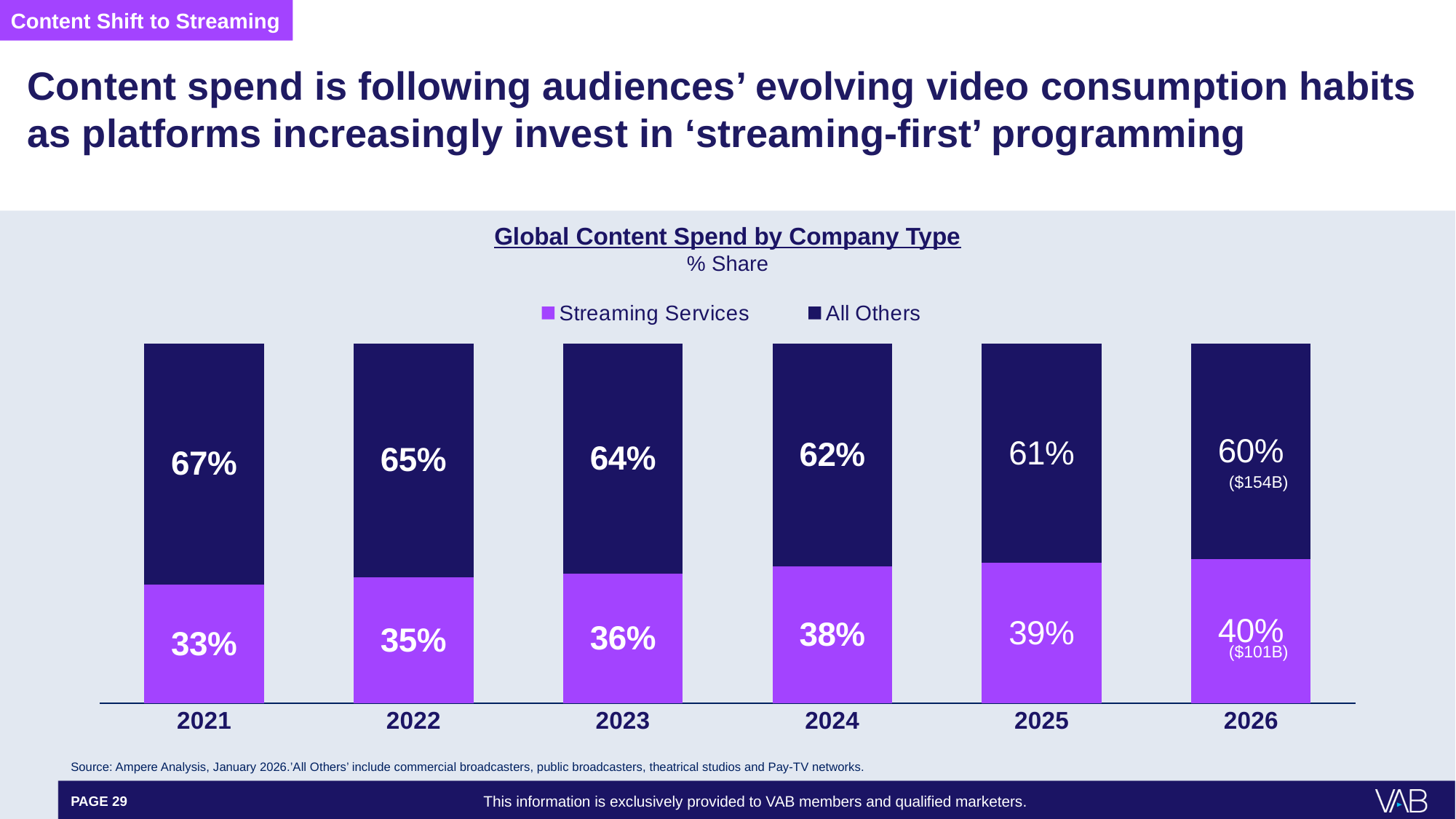
What kind of chart is shown? Stacked bar chart What is the Streaming Services share in 2026? 40% What is the Streaming Services share in 2021? 33% In which year is the All Others share lowest? 2026 What is the difference between the All Others share and the Streaming Services share in 2021? 34 percentage points What dollar amount is shown for All Others in 2026? $154B What is the All Others share in 2024? 62% Does the Streaming Services share rise or fall from 2021 to 2026? Rise How many years are shown on the x axis? 6 In which year is the Streaming Services share highest? 2026 How many series does the legend list? 2 Which is larger in 2025, the Streaming Services share or the All Others share? All Others